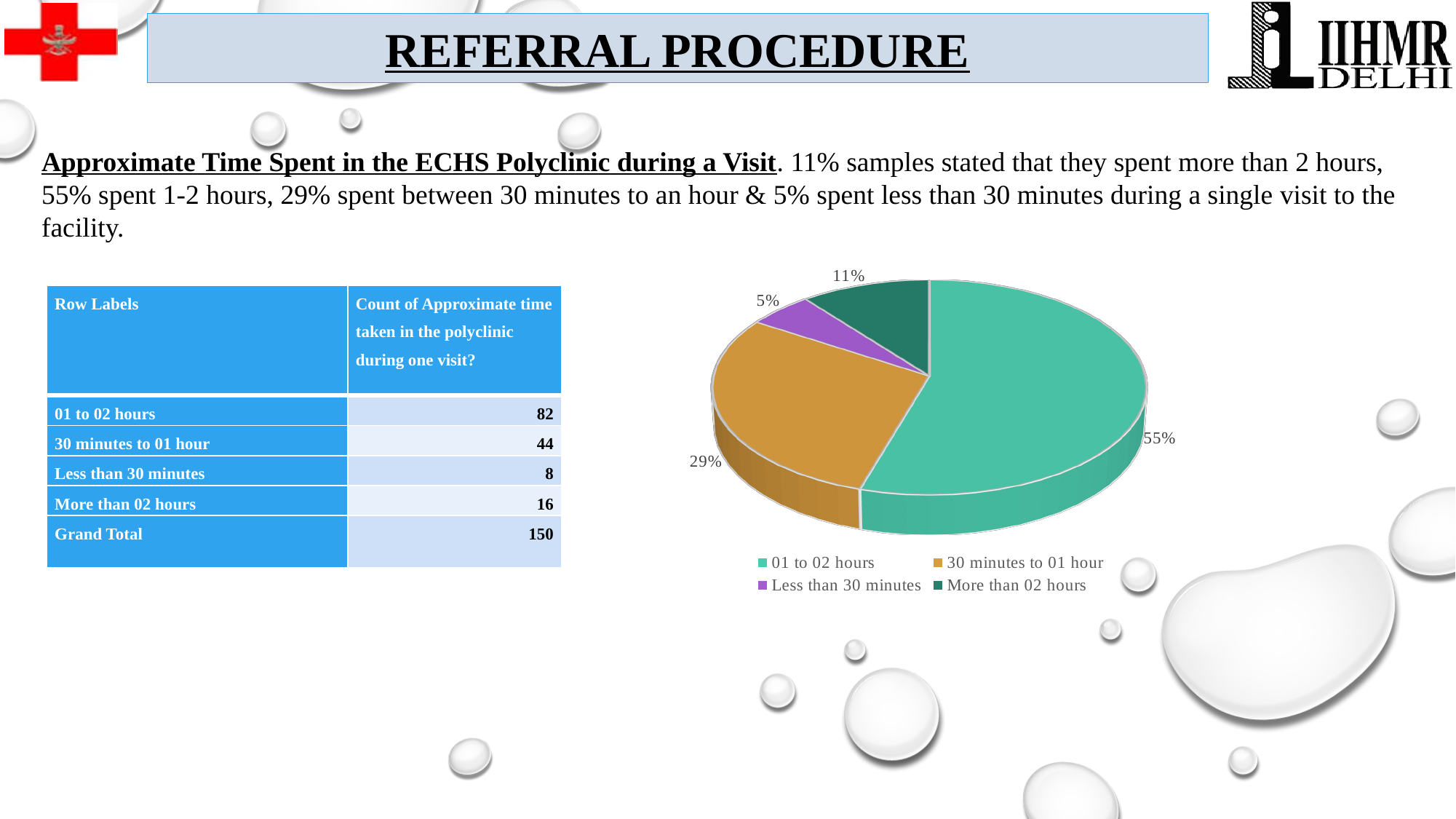
What percentage of the pie chart is labelled for '01 to 02 hours'? 55% What percentage of the pie chart is labelled for '30 minutes to 01 hour'? 29% How many entries does the pie chart legend list? 4 What colour is the '01 to 02 hours' slice in the pie chart? Teal/green Which slice is larger in the pie chart: '30 minutes to 01 hour' or 'More than 02 hours'? 30 minutes to 01 hour What percentage of the pie chart is labelled for 'Less than 30 minutes'? 5% What is the difference in percentage points between the '01 to 02 hours' slice and the '30 minutes to 01 hour' slice? 26% Which category has the largest slice in the pie chart? 01 to 02 hours Which category has the smallest slice in the pie chart? Less than 30 minutes What kind of chart is shown on the slide? Pie chart What percentage of the pie chart is labelled for 'More than 02 hours'? 11% How many slices does the pie chart have? 4